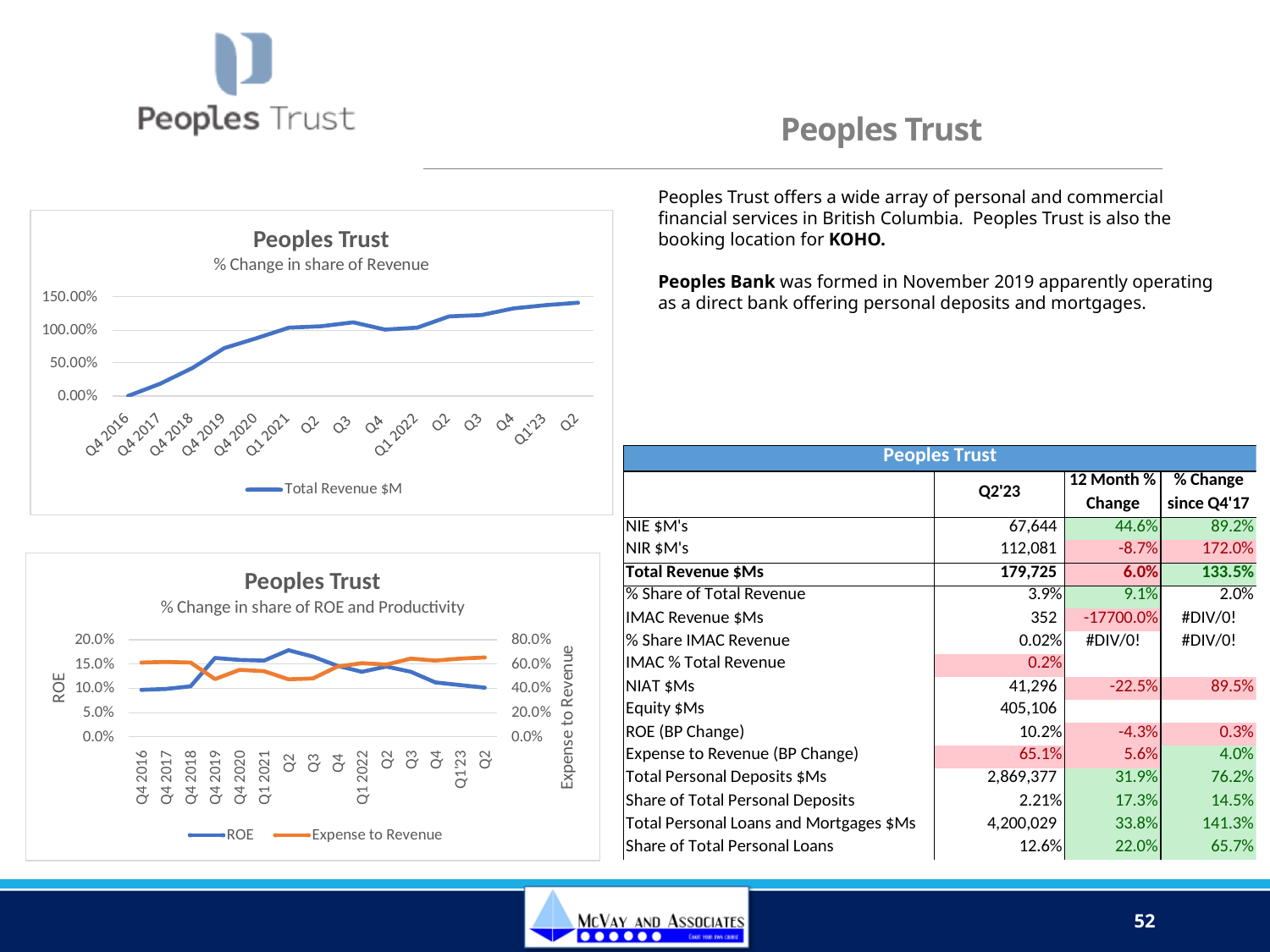
In the bottom-left chart '% Change in share of ROE and Productivity', how many series does the legend list? 2 In the top-left chart '% Change in share of Revenue', how many series does the legend list? 1 In the top-left chart '% Change in share of Revenue', which quarter has the highest value? Q2 (the last point, Q2 2023) In the top-left chart '% Change in share of Revenue', how many quarters are plotted along the x axis? 15 In the bottom-left chart '% Change in share of ROE and Productivity', which series is plotted in orange? Expense to Revenue In the top-left chart '% Change in share of Revenue', is the value for Q4 2019 greater or less than 50.00%? greater In the top-left chart '% Change in share of Revenue', is the value for Q4 2017 greater or less than 50.00%? less In the bottom-left chart '% Change in share of ROE and Productivity', is the Expense to Revenue value for Q4 2019 greater or less than 60.0%? less In the top-left chart '% Change in share of Revenue', which quarter has the lowest value? Q4 2016 In the top-left chart '% Change in share of Revenue', do the values generally rise or fall from Q4 2016 to Q2 2023? Rise In the top-left chart '% Change in share of Revenue', what is the name of the series shown in the legend? Total Revenue $M What kind of chart is the top-left chart titled 'Peoples Trust % Change in share of Revenue'? Line chart